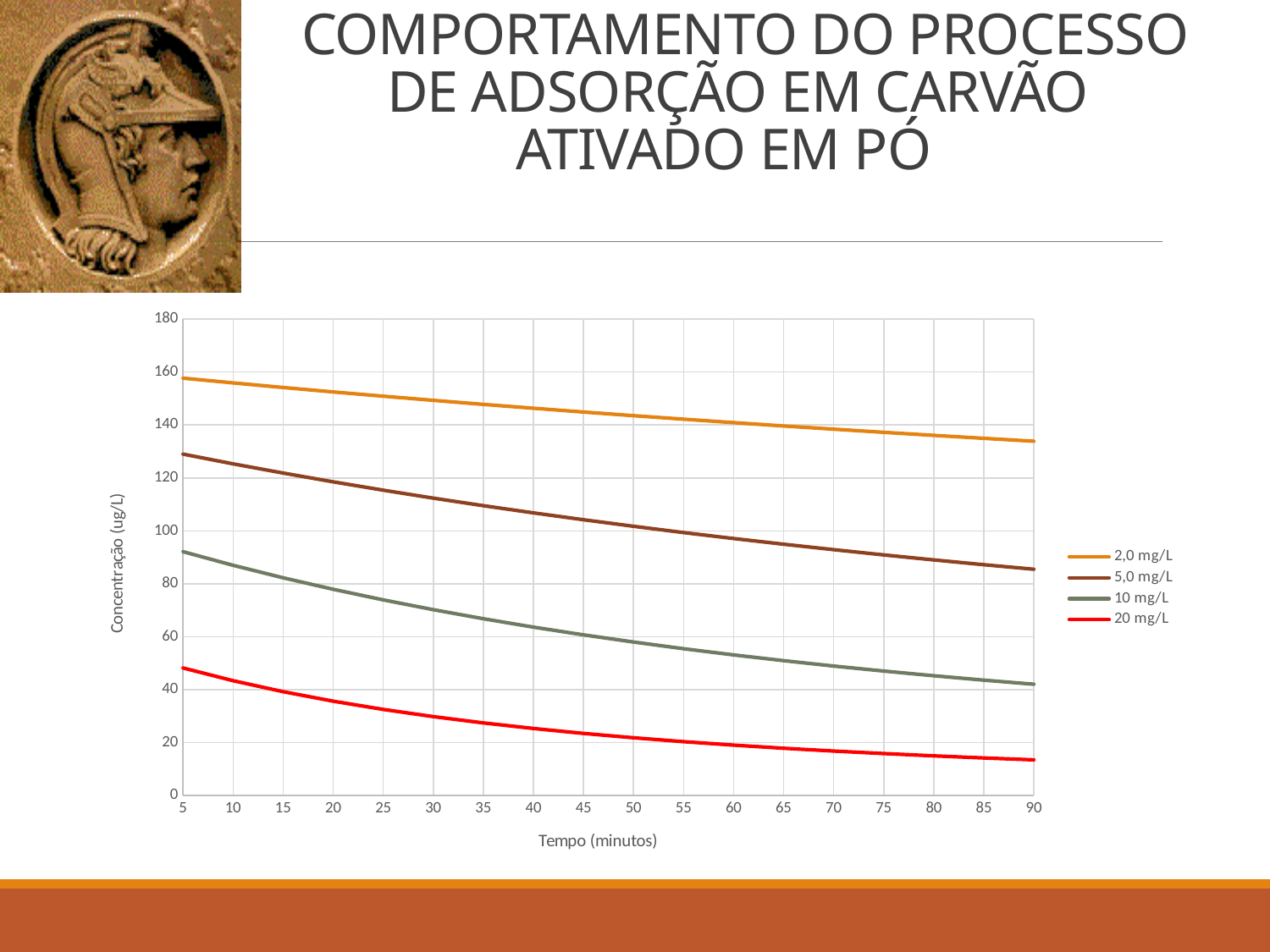
Which series has the lowest concentration values across the whole time range? 20 mg/L Do the values of the 20 mg/L series rise or fall as time increases along the x axis? fall Do the values of the 2,0 mg/L series rise or fall from 5 to 90 minutes? fall Is the value for the 20 mg/L series at 90 minutes greater or less than 20? less Is the value for the 10 mg/L series at 5 minutes greater or less than 80? greater What kind of chart is shown on the slide? line chart What is the title of the x axis of the chart? Tempo (minutos) At 90 minutes, which series has the larger value: 2,0 mg/L or 5,0 mg/L? 2,0 mg/L Is the value for the 2,0 mg/L series at 5 minutes greater or less than 140? greater Which series has the highest concentration values across the whole time range? 2,0 mg/L How many series does the legend list? 4